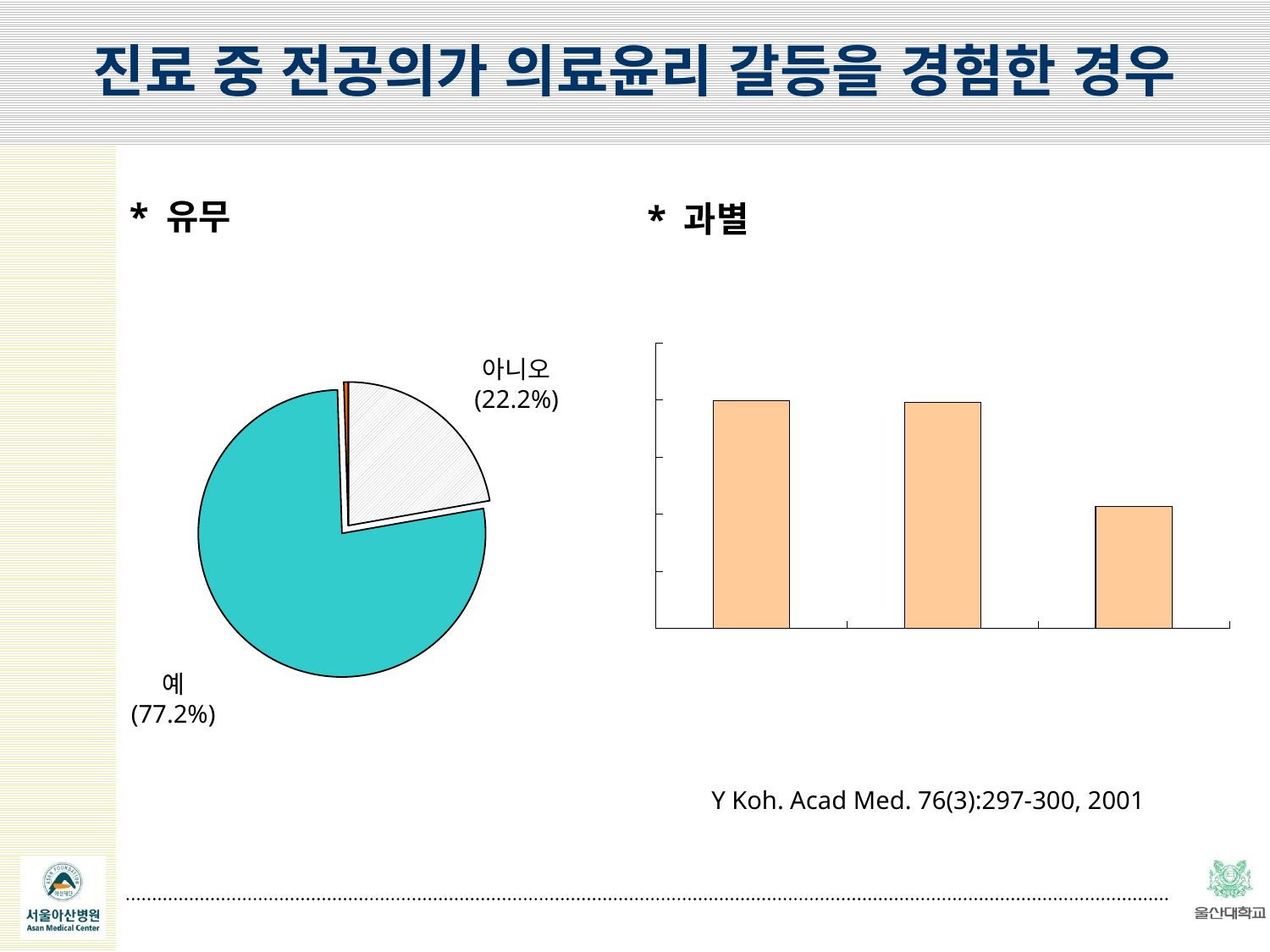
What colour are the bars in the chart on the right (과별)? light orange In the pie chart on the left (유무), what percentage is shown for 아니오? 22.2% In the pie chart on the left (유무), what percentage is shown for 예? 77.2% In the pie chart on the left (유무), which labeled slice is the largest? 예 In the pie chart on the left (유무), which labeled slice is the smallest? 아니오 In the bar chart on the right (과별), which is taller, the leftmost bar or the rightmost bar? leftmost bar What kind of chart is the chart on the right (과별)? bar chart In the pie chart on the left (유무), what is the difference in percentage points between 예 and 아니오? 55.0% In the bar chart on the right (과별), which bar is the lowest: the leftmost, the middle, or the rightmost? rightmost What kind of chart is the chart on the left (유무)? pie chart How many bars are plotted in the chart on the right (과별)? 3 In the pie chart on the left (유무), which slice is larger, 예 or 아니오? 예